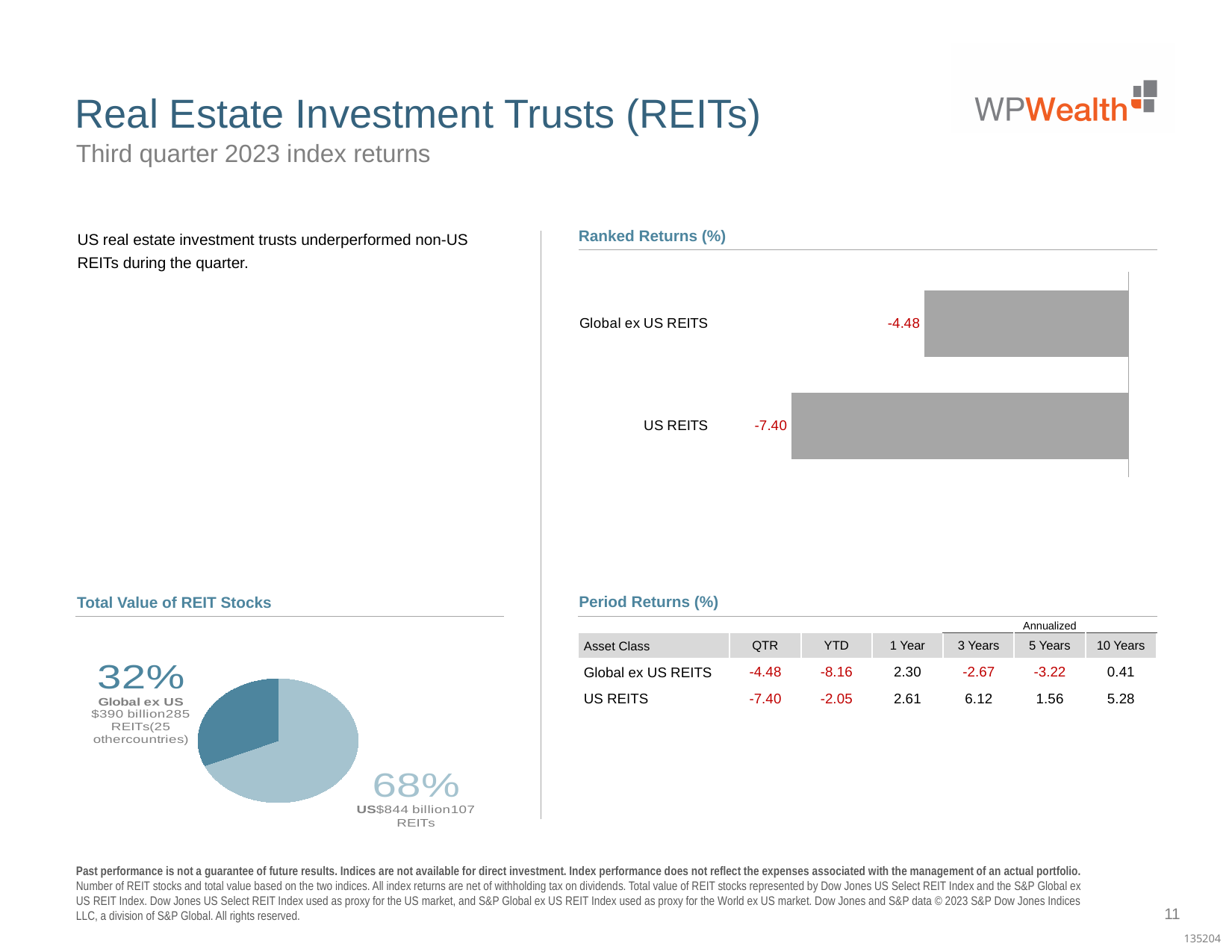
How many categories are shown in the Ranked Returns (%) chart? 2 In the Total Value of REIT Stocks chart, what share of the pie is US? 68% In the Total Value of REIT Stocks chart, which slice is larger, US or Global ex US? US In the Ranked Returns (%) chart, what is the value for US REITS? -7.40 In the Total Value of REIT Stocks chart, what share of the pie is Global ex US? 32% What kind of chart is the Total Value of REIT Stocks chart? Pie chart What kind of chart is the Ranked Returns (%) chart? Bar chart In the Ranked Returns (%) chart, what is the difference between the values for Global ex US REITS and US REITS? 2.92 In the Ranked Returns (%) chart, which is larger, the value for Global ex US REITS or the value for US REITS? Global ex US REITS In the Ranked Returns (%) chart, what is the value for Global ex US REITS? -4.48 In the Ranked Returns (%) chart, which category has the highest value? Global ex US REITS In the Ranked Returns (%) chart, which category has the lowest value? US REITS